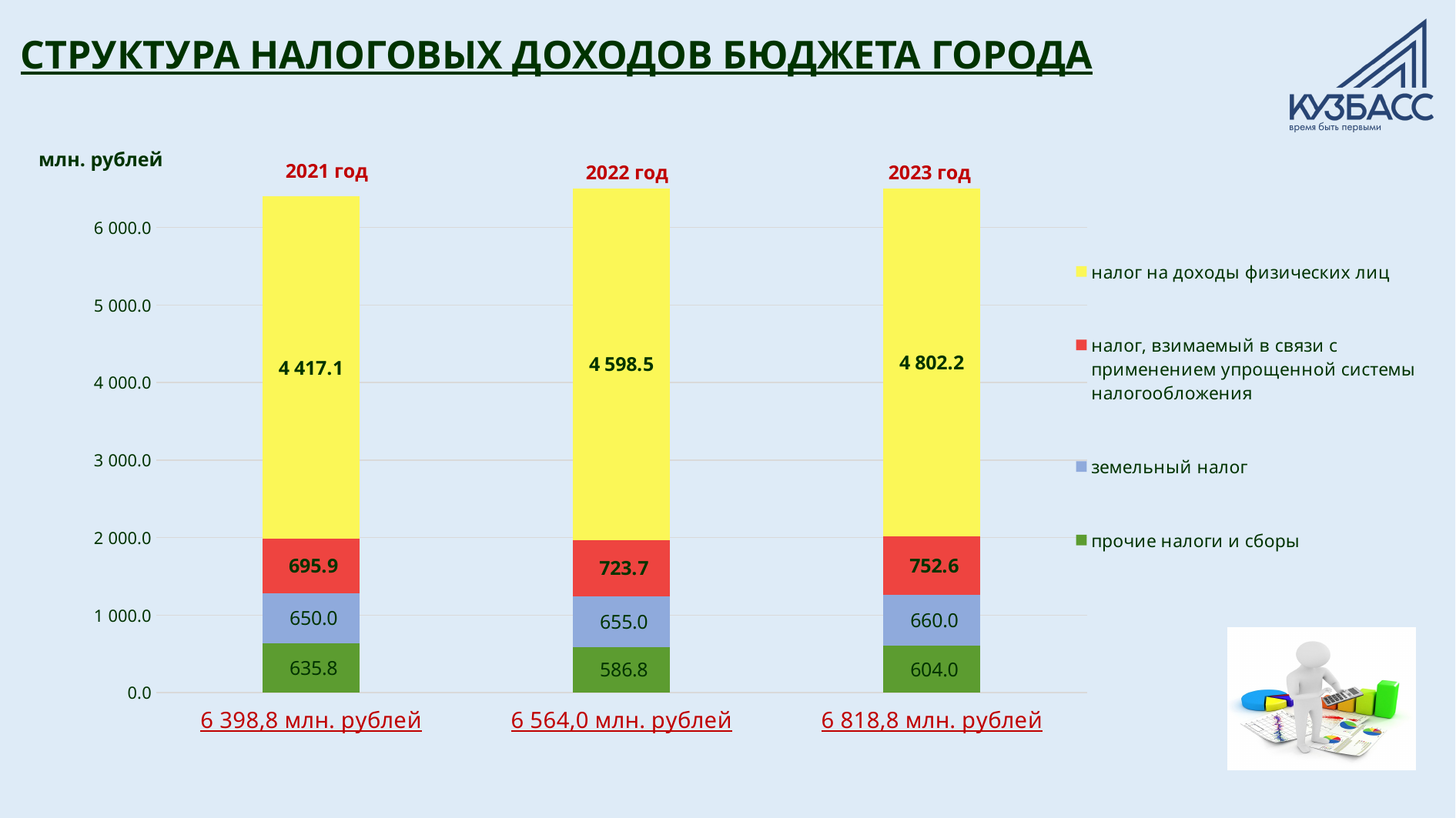
How many series does the legend list? 4 What is the value of земельный налог for 2022 год? 655.0 In which year is прочие налоги и сборы the lowest? 2022 год What is the total of the stacked bar for 2022 год? 6 564,0 млн. рублей What is the value of налог, взимаемый в связи с применением упрощенной системы налогообложения for 2022 год? 723.7 By how much did налог на доходы физических лиц increase from 2021 год to 2023 год? 385.1 How many years (bars) are shown in the chart? 3 Which is larger in 2021 год: земельный налог or прочие налоги и сборы? земельный налог What is the value of налог на доходы физических лиц for 2021 год? 4 417.1 In which year is налог на доходы физических лиц the highest? 2023 год What is the value of прочие налоги и сборы for 2023 год? 604.0 What kind of chart is shown on the slide? stacked bar chart